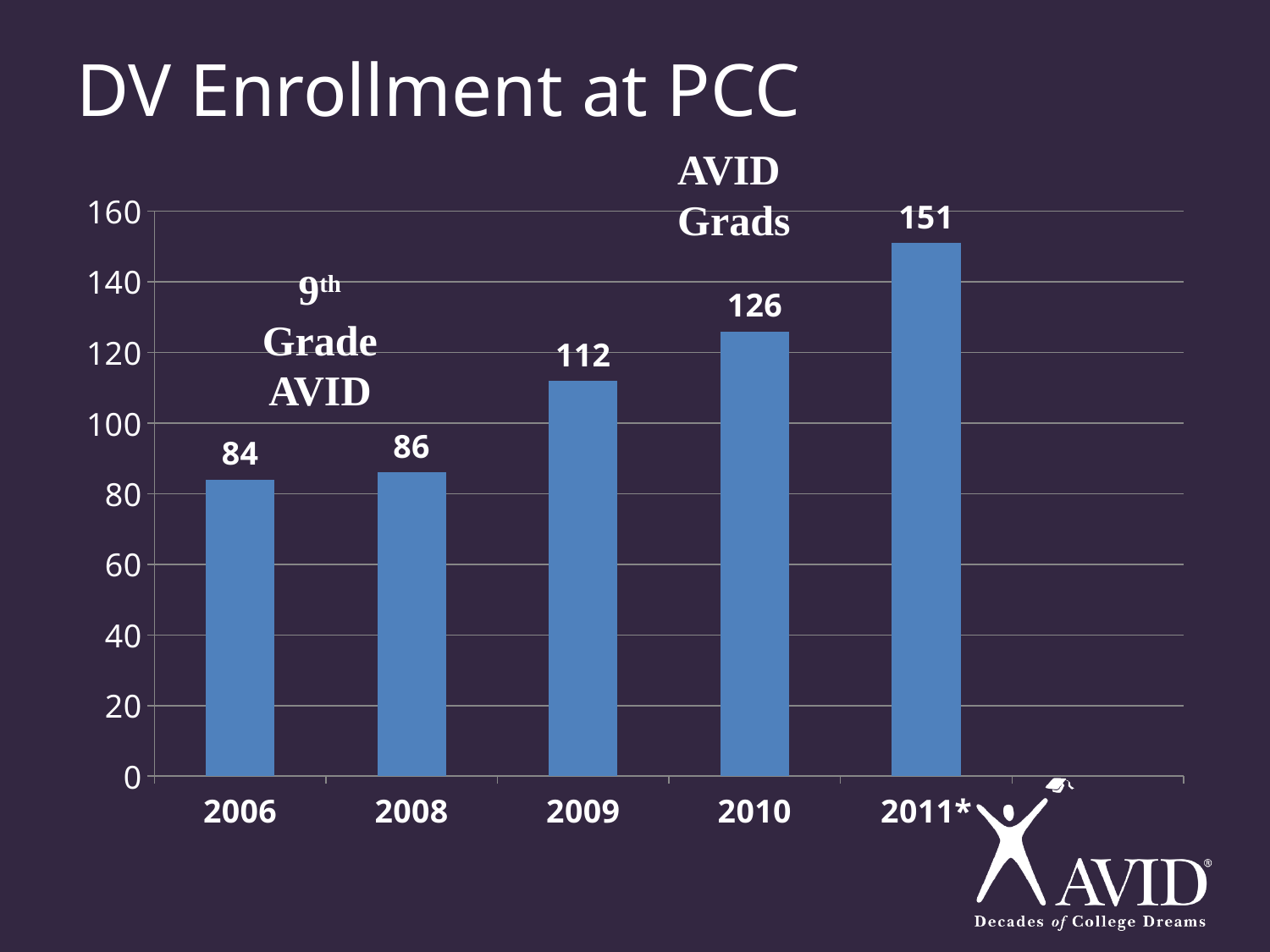
What is the value shown for 2011*? 151 What is the DV enrollment value for 2006? 84 What is the DV enrollment value for 2009? 112 Which is larger, the value for 2010 or the value for 2009? 2010 What kind of chart is shown on the slide? bar chart How many years are shown on the x axis? 5 What is the difference between the 2009 and 2008 values? 26 Do the values rise or fall from 2006 to 2011*? rise What is the difference between the 2011* and 2010 values? 25 Which year has the highest enrollment? 2011* Which year has the lowest enrollment? 2006 Is the value for 2010 greater or less than 120? greater